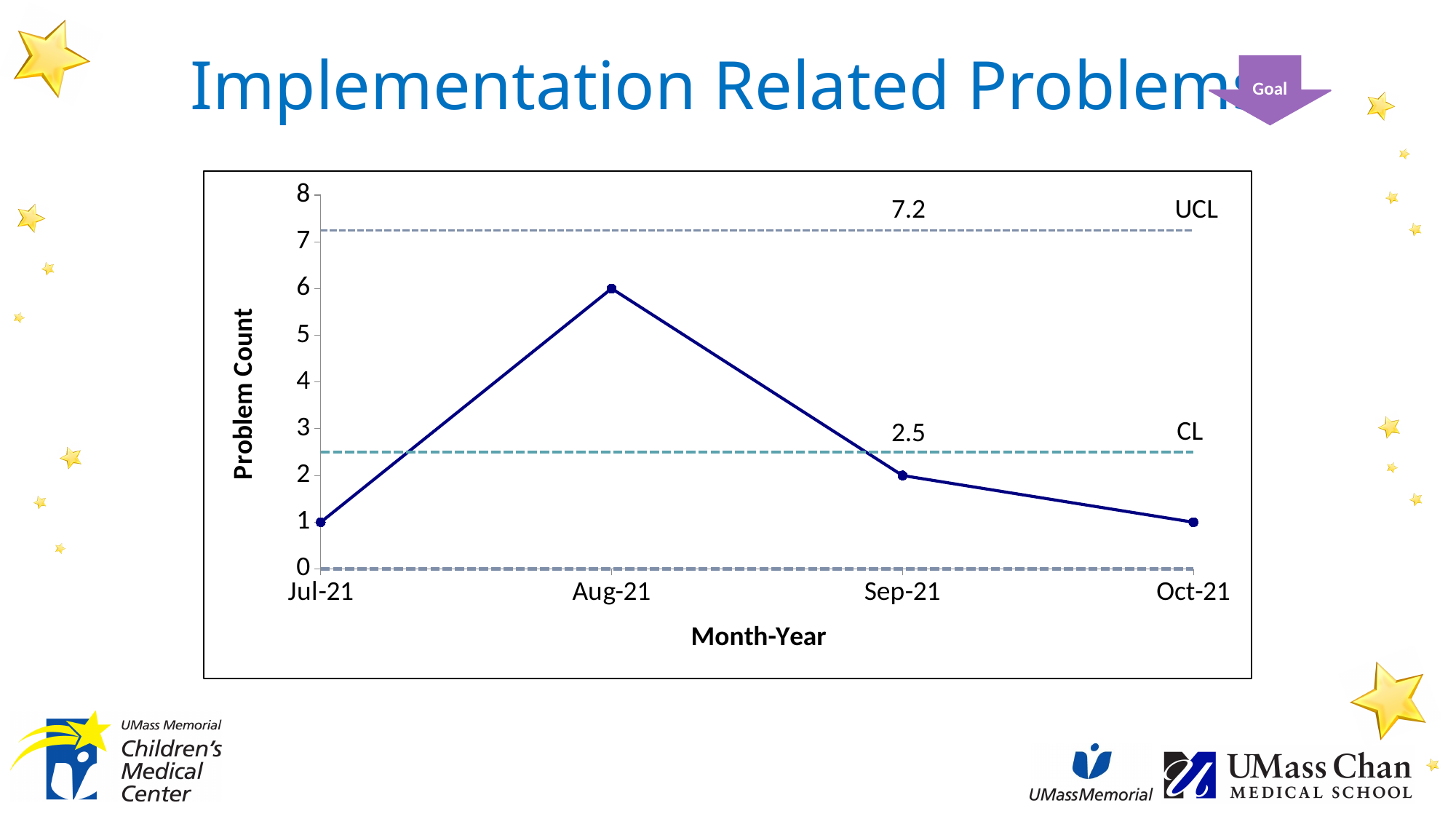
What is the value of the UCL line? 7.2 What is the problem count for Jul-21? 1 What is the difference in problem count between Aug-21 and Sep-21? 4 Which has a larger problem count, Aug-21 or Oct-21? Aug-21 What kind of chart is shown on the slide? line chart What is the value of the CL line? 2.5 What is the problem count for Aug-21? 6 How many months are plotted on the x axis? 4 What is the problem count for Sep-21? 2 What is the label of the y axis? Problem Count Does the problem count rise or fall from Aug-21 to Oct-21? fall Which month has the highest problem count? Aug-21